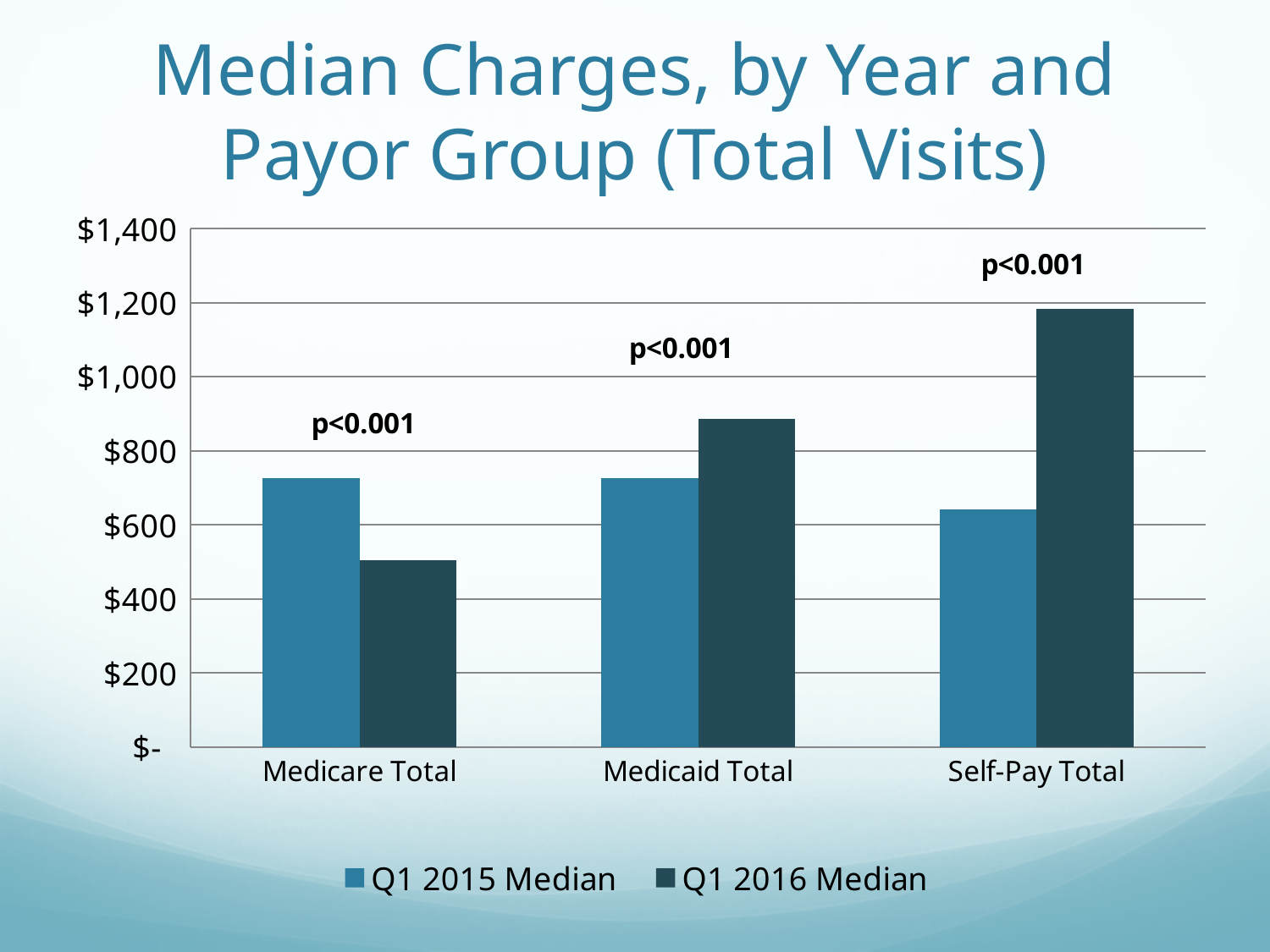
Which payor group has the highest Q1 2016 Median charge? Self-Pay Total Which payor group has the lowest Q1 2015 Median charge? Self-Pay Total What p-value annotation is shown above each group of bars? p<0.001 How many payor group categories are shown on the x axis? 3 Which payor group has the lowest Q1 2016 Median charge? Medicare Total What kind of chart is shown on the slide? bar chart For Medicare Total, which is larger: the Q1 2015 Median or the Q1 2016 Median? Q1 2015 Median Is the Q1 2016 Median value for Self-Pay Total greater or less than $1,000? greater How many series does the legend list? 2 Is the Q1 2016 Median value for Medicare Total greater or less than $600? less For Self-Pay Total, which is larger: the Q1 2015 Median or the Q1 2016 Median? Q1 2016 Median Is the Q1 2016 Median value for Medicaid Total greater or less than $800? greater